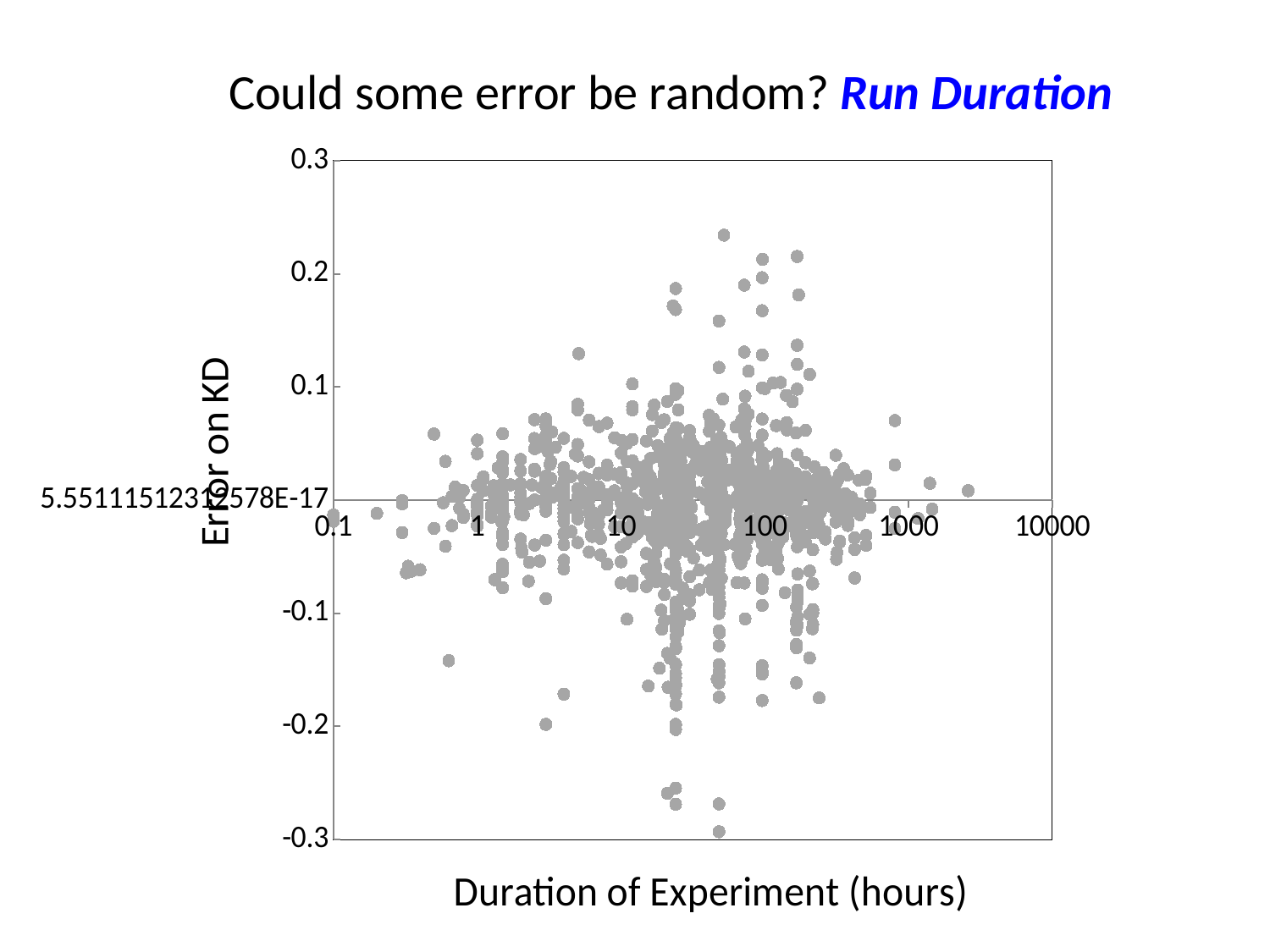
What is the largest tick value shown on the x axis? 10000 What is the label of the x axis? Duration of Experiment (hours) Is the largest Duration of Experiment plotted greater or less than 1000 hours? greater What kind of chart is shown on the slide? Scatter plot What is the maximum value shown on the y axis? 0.3 What is the label of the y axis? Error on KD